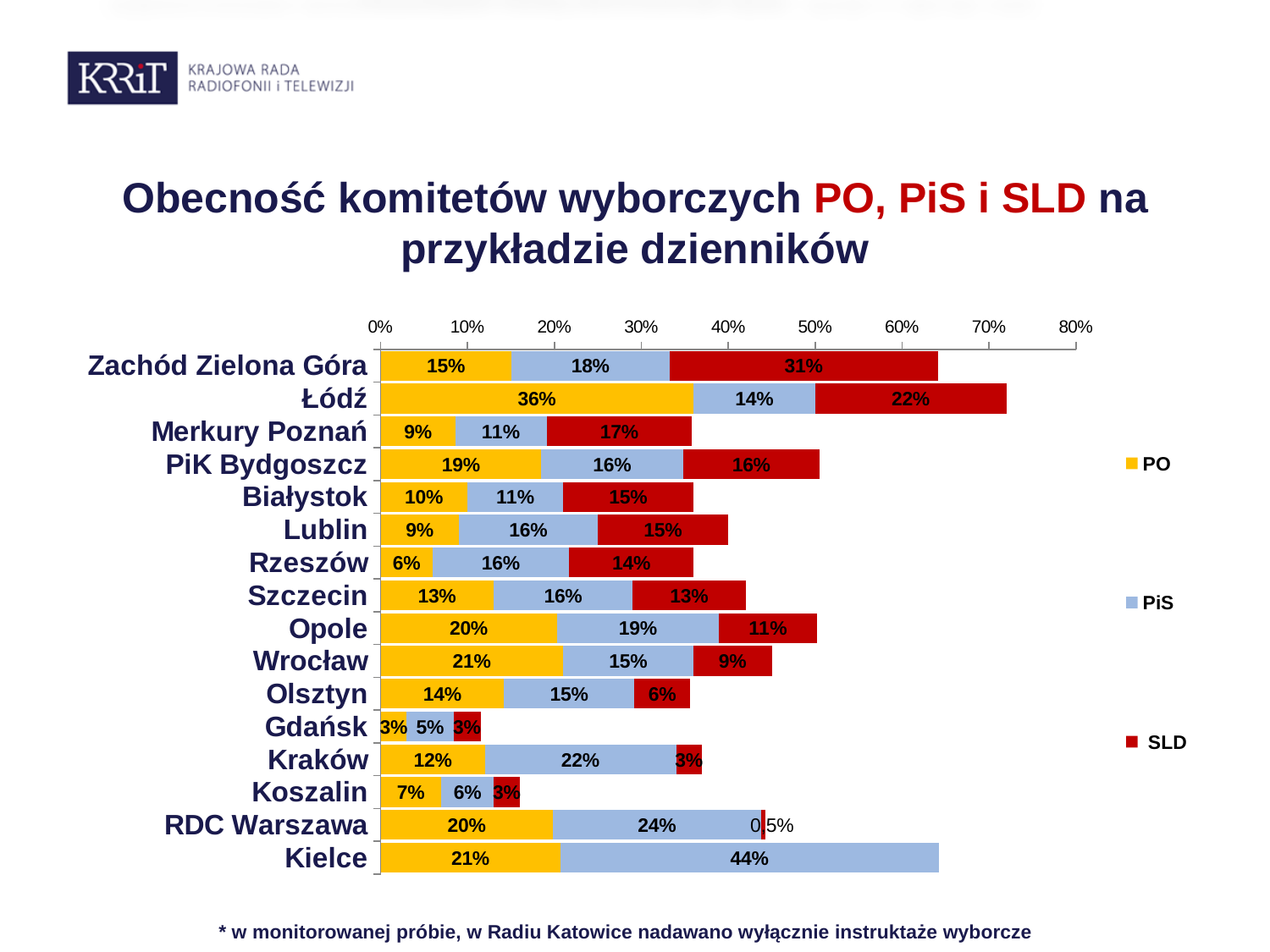
What is the PiS value for Kielce? 44% How many series does the legend list? 3 What is the SLD value for Zachód Zielona Góra? 31% What is the difference between the PiS values for Kraków and Koszalin? 16% What is the total of the stacked bar for Łódź? 72% Which is larger, the PO value for Opole or the PO value for Szczecin? Opole Which station has the highest SLD value? Zachód Zielona Góra What is the PO value for Łódź? 36% Which station has the highest PO value? Łódź How many radio stations (categories) are shown in the chart? 16 What is the total of the stacked bar for Gdańsk? 11% What kind of chart is shown on the slide? stacked bar chart